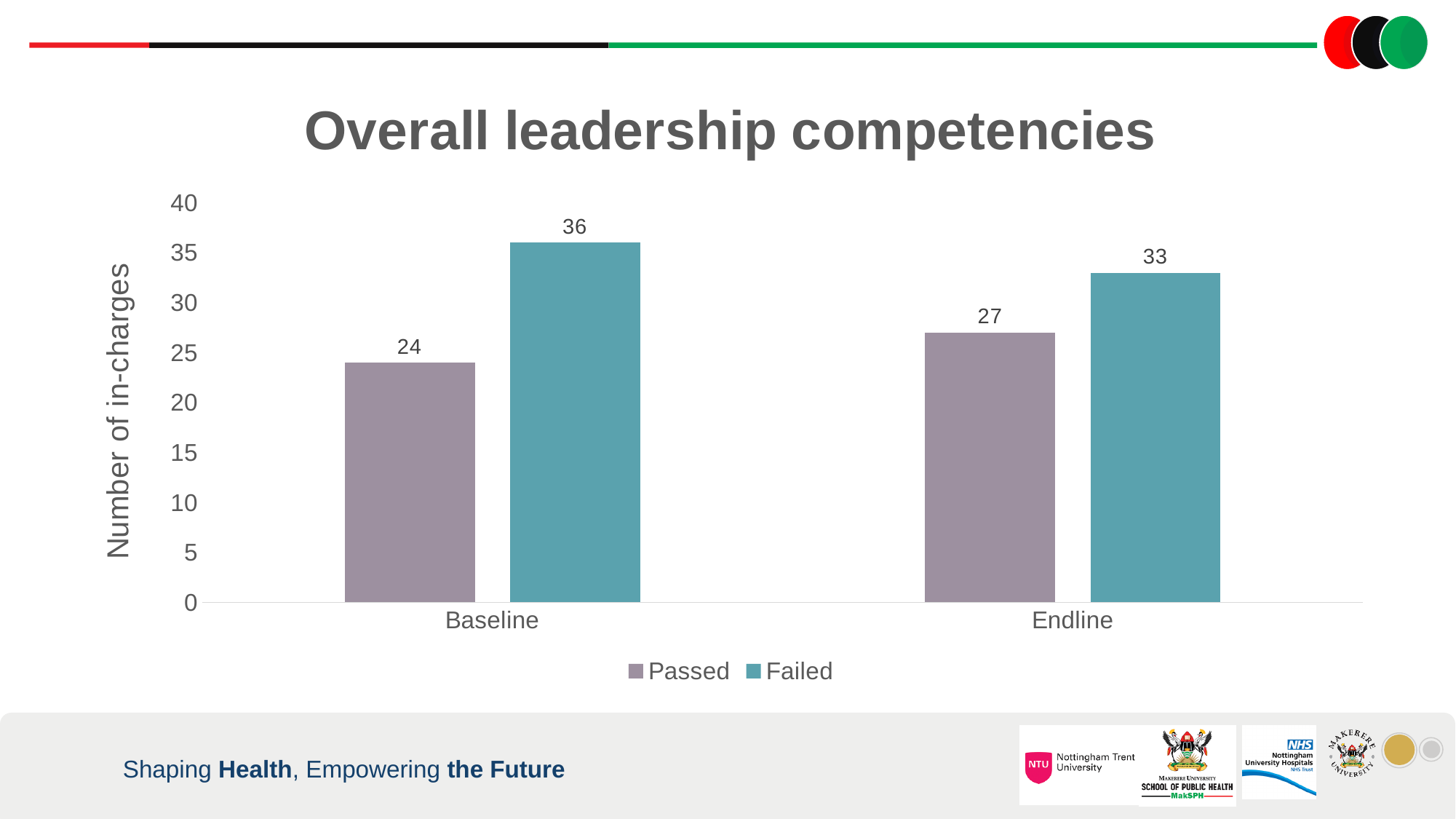
What is the value for Passed at Baseline? 24 How many series does the legend list? 2 Which bar has the highest value on the chart? Failed at Baseline What is the label of the vertical axis? Number of in-charges What is the difference between Failed and Passed at Baseline? 12 What is the value for Failed at Endline? 33 What is the value for Failed at Baseline? 36 What kind of chart is shown on the slide? Bar chart Which bar has the lowest value on the chart? Passed at Baseline What is the value for Passed at Endline? 27 Which is larger, Passed at Endline or Passed at Baseline? Passed at Endline What is the difference between Failed and Passed at Endline? 6